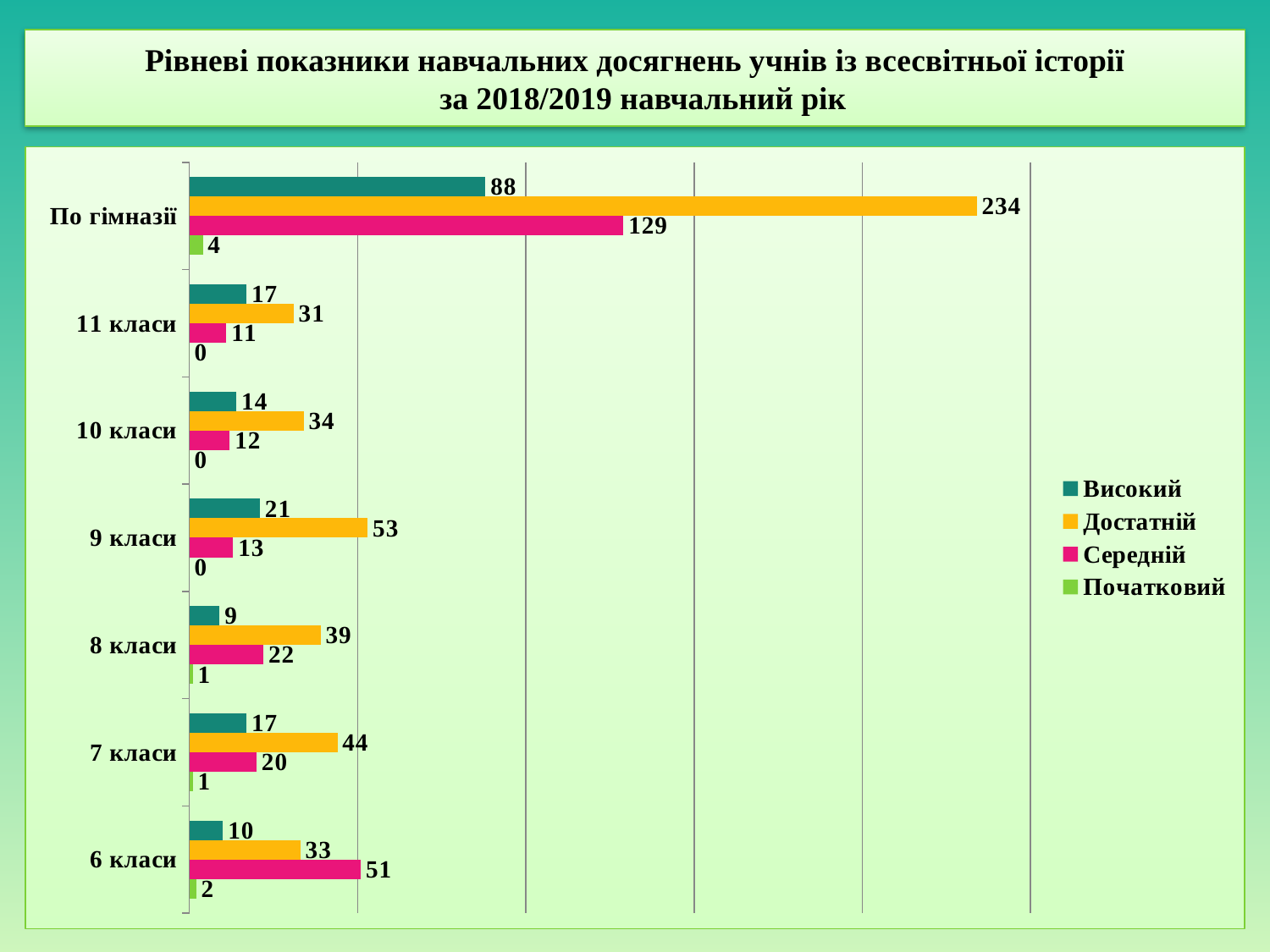
What is the value of Високий for 9 класи? 21 What is the value of Достатній for По гімназії? 234 What is the difference between the Достатній and Середній values for По гімназії? 105 What kind of chart is shown on the slide? bar chart Among the class groups (excluding По гімназії), which has the highest Достатній value? 9 класи How many series does the legend list? 4 What is the value of Початковий for 11 класи? 0 Which is larger for 6 класи: Достатній or Середній? Середній Among the class groups (excluding По гімназії), which has the lowest Високий value? 8 класи How many categories are shown on the y axis? 7 Which series is shown in green in the legend? Початковий What is the value of Середній for 6 класи? 51